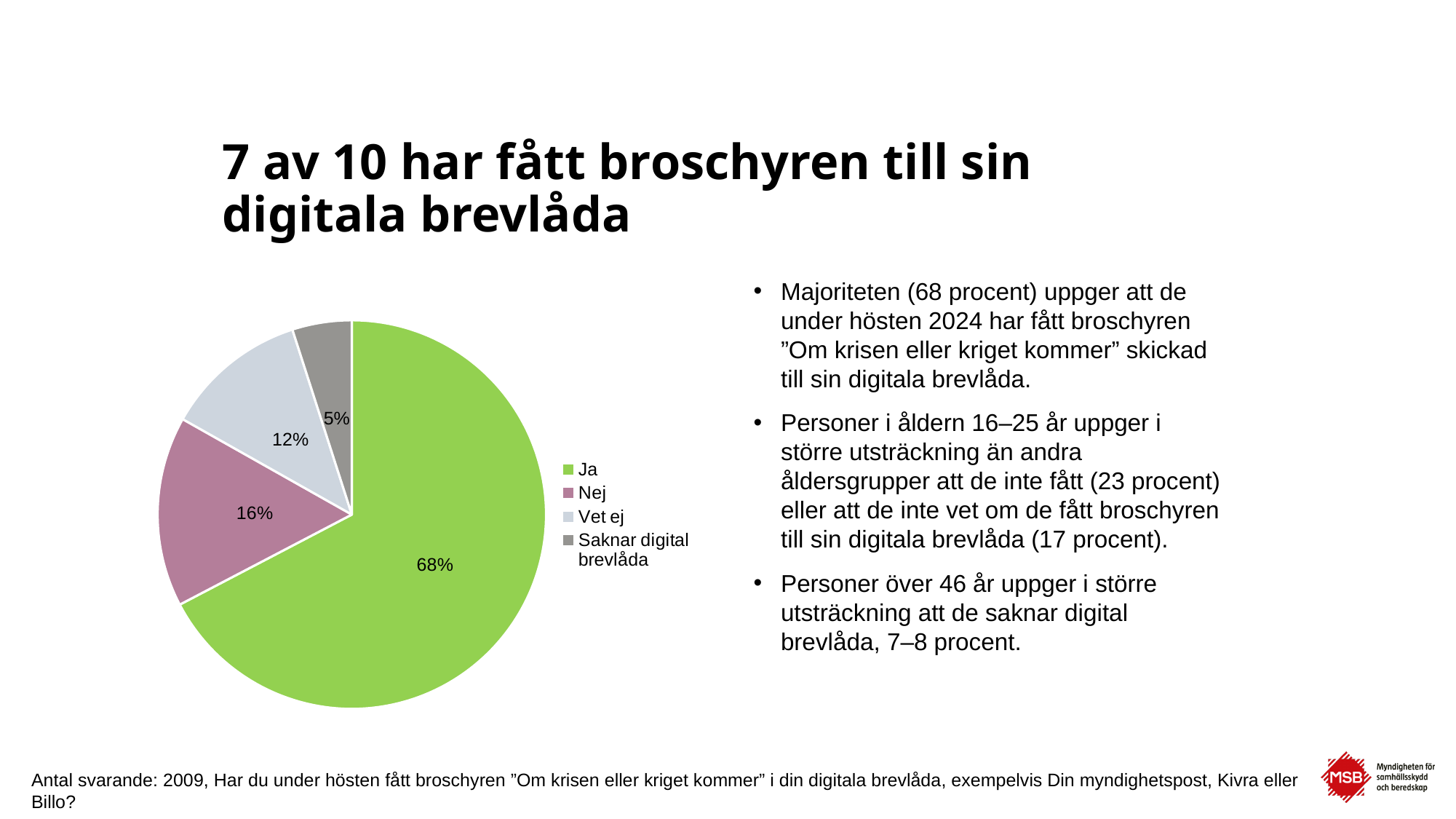
What is the value shown for "Nej"? 16% What share of the pie does the "Ja" slice represent? 68% How many categories does the pie chart show? 4 What is the value shown for "Vet ej"? 12% Which category has the largest slice of the pie? Ja What is the difference in percentage points between "Nej" and "Vet ej"? 4 Which is larger, the slice for "Vet ej" or the slice for "Saknar digital brevlåda"? Vet ej What is the value shown for "Saknar digital brevlåda"? 5% What kind of chart is shown on the slide? Pie chart Which category has the smallest slice of the pie? Saknar digital brevlåda What colour is the "Ja" slice in the pie chart? Green What is the difference in percentage points between "Ja" and "Nej"? 52